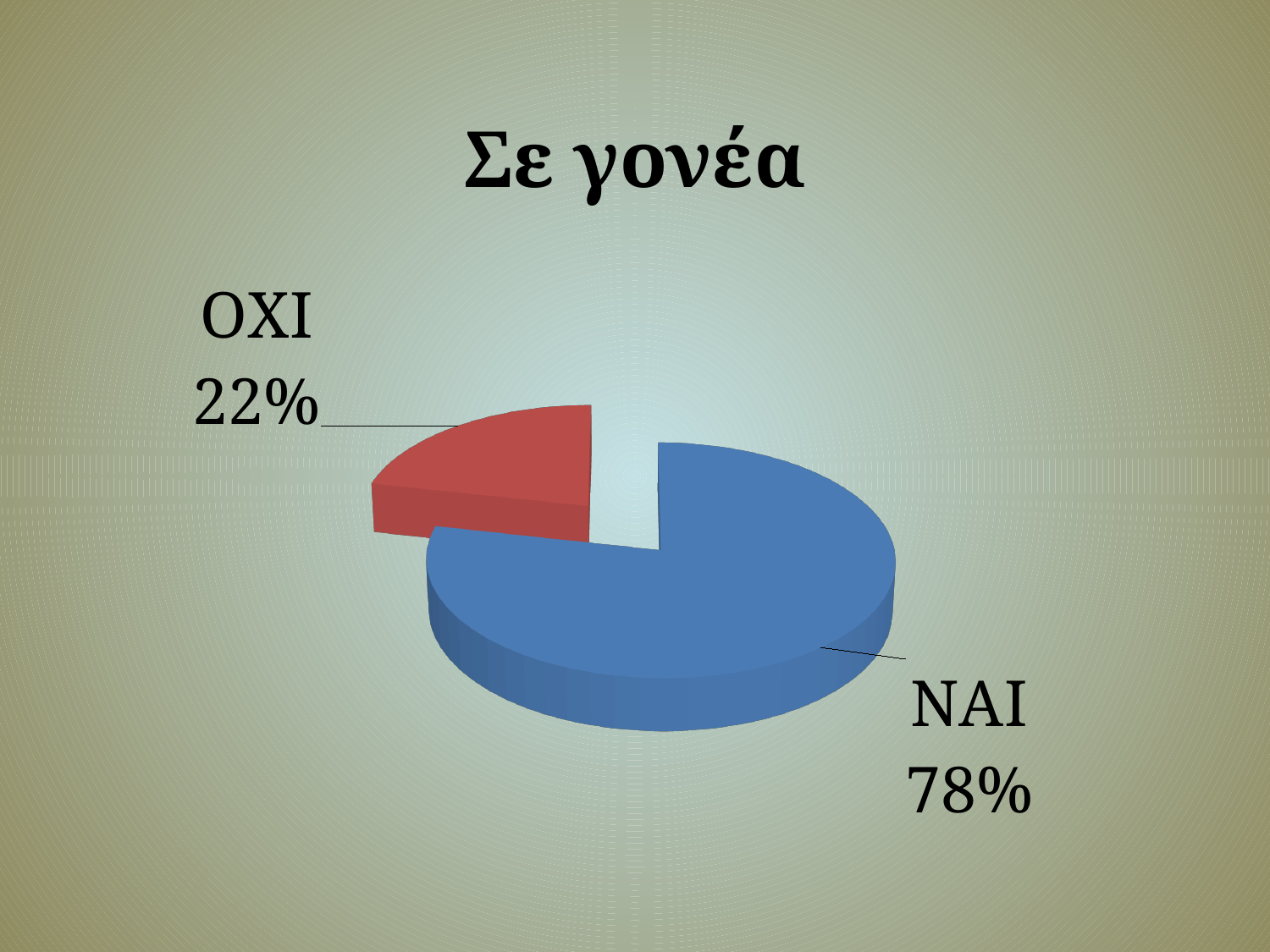
Which slice is the largest in the pie chart? ΝΑΙ Which slice is the smallest in the pie chart? ΟΧΙ Which is larger, the ΝΑΙ slice or the ΟΧΙ slice? ΝΑΙ What is the difference in percentage points between the ΝΑΙ and ΟΧΙ slices? 56 What share of the pie does the ΝΑΙ slice represent? 78% What kind of chart is shown on the slide? Pie chart What colour is the ΟΧΙ slice? Red What share of the pie does the ΟΧΙ slice represent? 22% What is the title of the chart? Σε γονέα How many slices does the pie chart have? 2